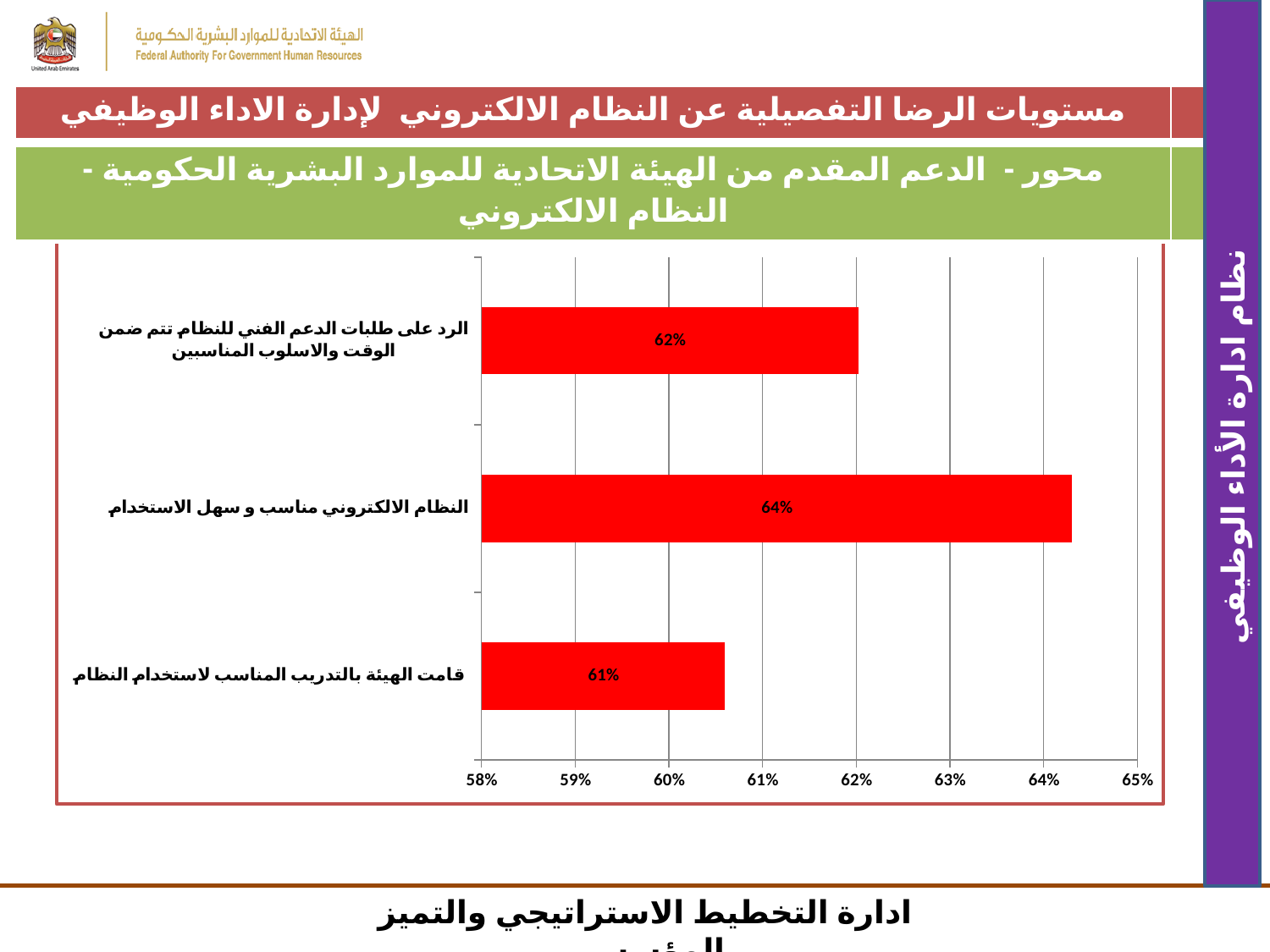
What is the value for "قامت الهيئة بالتدريب المناسب لاستخدام النظام"? 61% What kind of chart is shown on the slide? bar chart What is the value for "الرد على طلبات الدعم الفني للنظام تتم ضمن الوقت والاسلوب المناسبين"? 62% Which category has the lowest value? قامت الهيئة بالتدريب المناسب لاستخدام النظام Which category has the highest value? النظام الالكتروني مناسب و سهل الاستخدام What is the value for "النظام الالكتروني مناسب و سهل الاستخدام"? 64% What is the difference between the values for "الرد على طلبات الدعم الفني للنظام تتم ضمن الوقت والاسلوب المناسبين" and "قامت الهيئة بالتدريب المناسب لاستخدام النظام"? 1% What is the difference between the values for "النظام الالكتروني مناسب و سهل الاستخدام" and "قامت الهيئة بالتدريب المناسب لاستخدام النظام"? 3% How many categories are shown in the chart? 3 Which is larger: the value for "الرد على طلبات الدعم الفني للنظام تتم ضمن الوقت والاسلوب المناسبين" or the value for "النظام الالكتروني مناسب و سهل الاستخدام"? النظام الالكتروني مناسب و سهل الاستخدام What colour are the bars in the chart? red Is the value for "قامت الهيئة بالتدريب المناسب لاستخدام النظام" greater or less than 62%? less